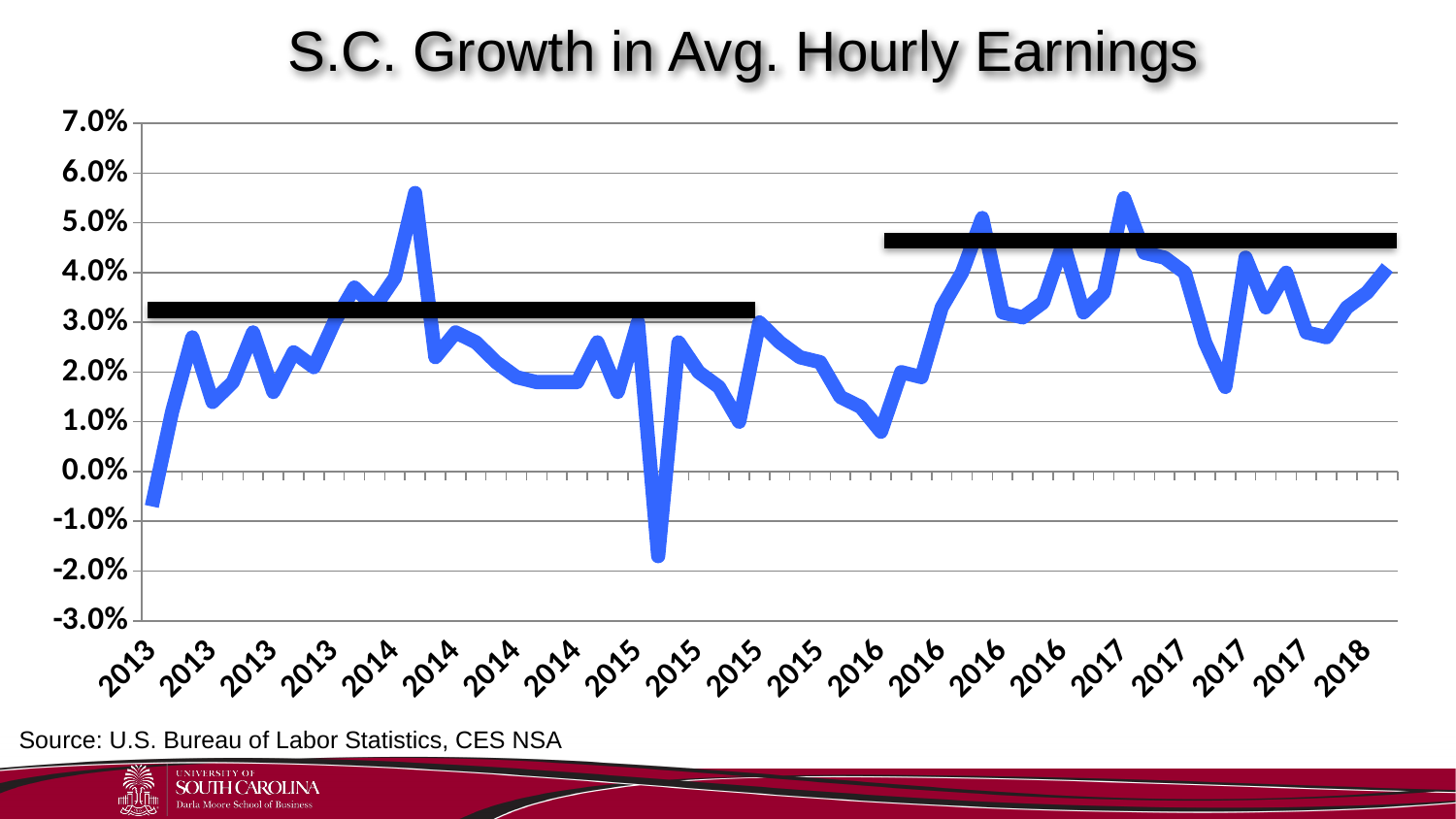
Is the first point of the blue line, at the start of 2013, greater or less than 0.0%? less Is the black horizontal bar covering 2013 to 2015 greater or less than 4.0%? less What kind of chart is shown on the slide? line chart Is the peak of the blue line in 2014 greater or less than 5.0%? greater Which year is the last label on the horizontal axis? 2018 What source is cited below the chart? U.S. Bureau of Labor Statistics, CES NSA What is the title of the chart? S.C. Growth in Avg. Hourly Earnings What is the highest value shown on the vertical axis? 7.0% Which black horizontal bar is higher: the one covering 2013 to 2015 or the one covering 2016 to 2018? the one covering 2016 to 2018 What is the lowest value shown on the vertical axis? -3.0%